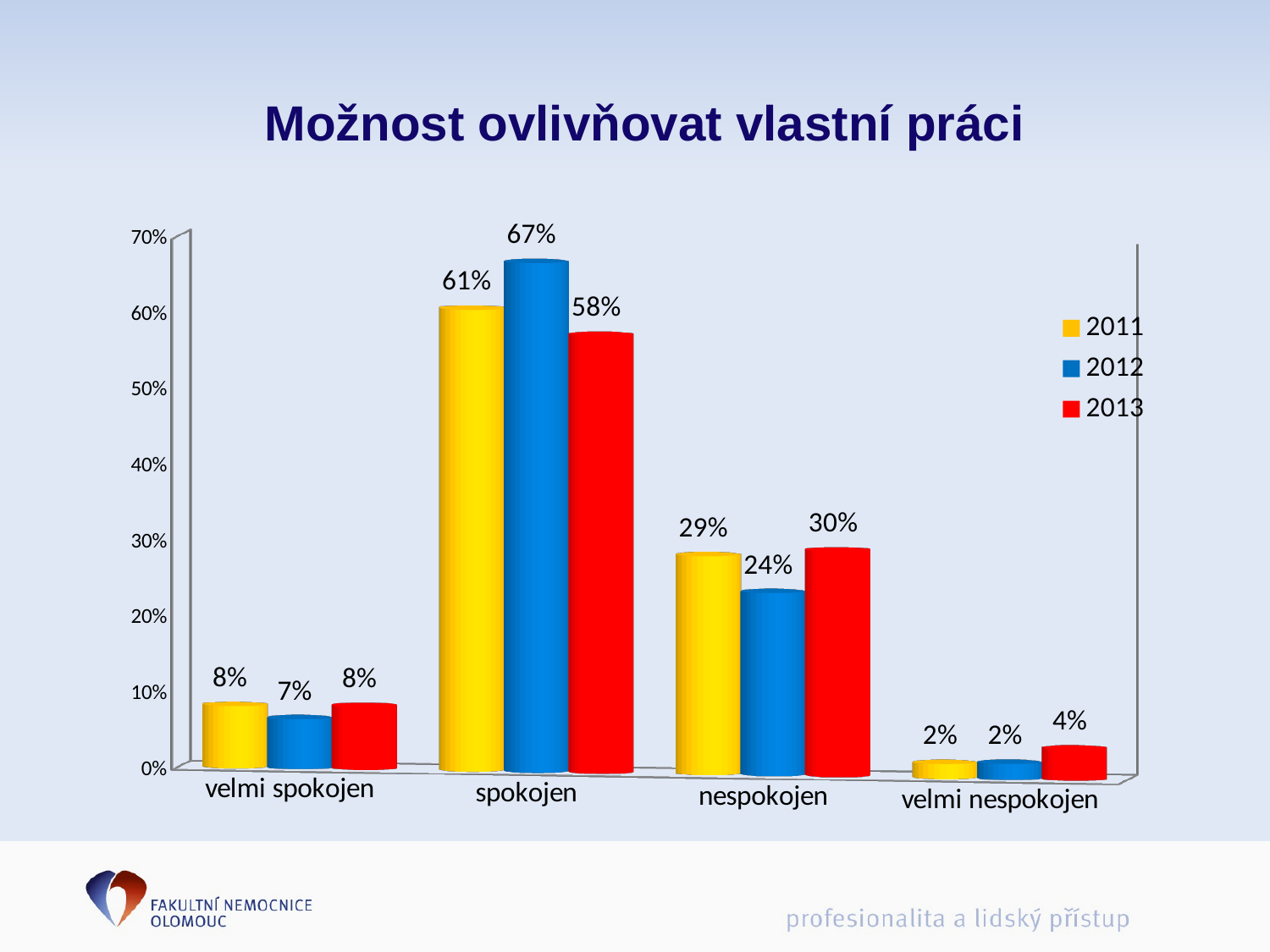
What is the value for 'spokojen' in the 2012 series? 67% How many series does the legend list? 3 Which is larger for 'nespokojen': the 2011 value or the 2012 value? 2011 What kind of chart is shown on the slide? bar chart What is the difference between the 2012 and 2013 values for 'spokojen'? 9% What is the value for 'velmi nespokojen' in the 2013 series? 4% What is the title of the chart? Možnost ovlivňovat vlastní práci Which category has the lowest value in the 2012 series? velmi nespokojen How many categories are shown on the x axis? 4 What is the value for 'nespokojen' in the 2013 series? 30% Which category has the highest value in the 2011 series? spokojen What is the value for 'velmi spokojen' in the 2011 series? 8%